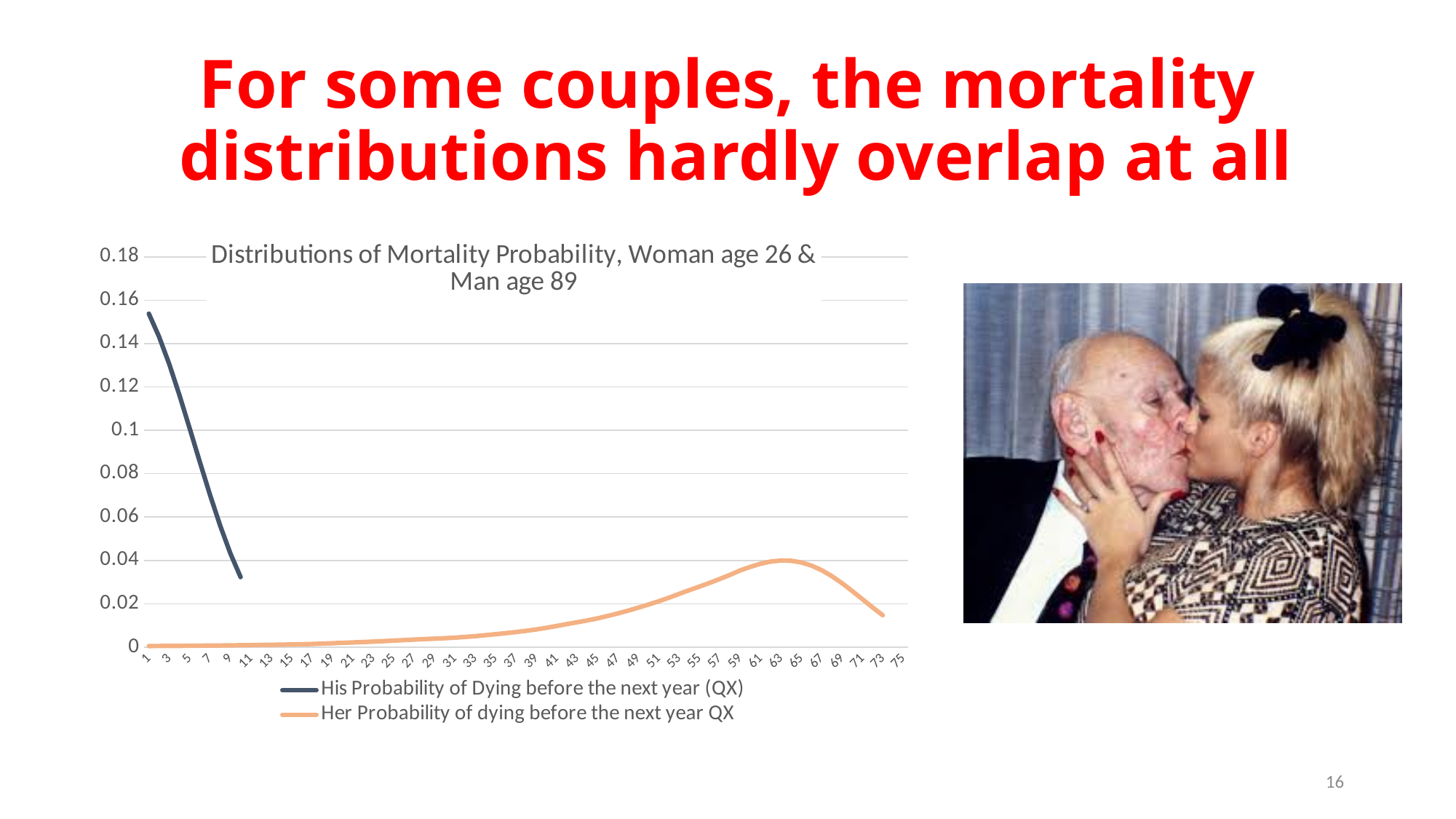
Does the line for His Probability of Dying before the next year (QX) rise or fall as the x axis increases? Fall Is the value for His Probability of Dying at x = 1 greater or less than 0.14? greater What is the highest value shown on the chart's vertical axis? 0.18 What kind of chart is shown on the slide? Line chart Which series is drawn in the dark blue-grey line? His Probability of Dying before the next year (QX) Is the value for Her Probability of dying at x = 21 greater or less than 0.02? less Is the peak value of Her Probability of dying before the next year greater or less than 0.02? greater How many series does the chart's legend list? 2 Which series reaches the higher peak value, His Probability of Dying or Her Probability of dying? His Probability of Dying before the next year (QX) What is the title of the chart? Distributions of Mortality Probability, Woman age 26 & Man age 89